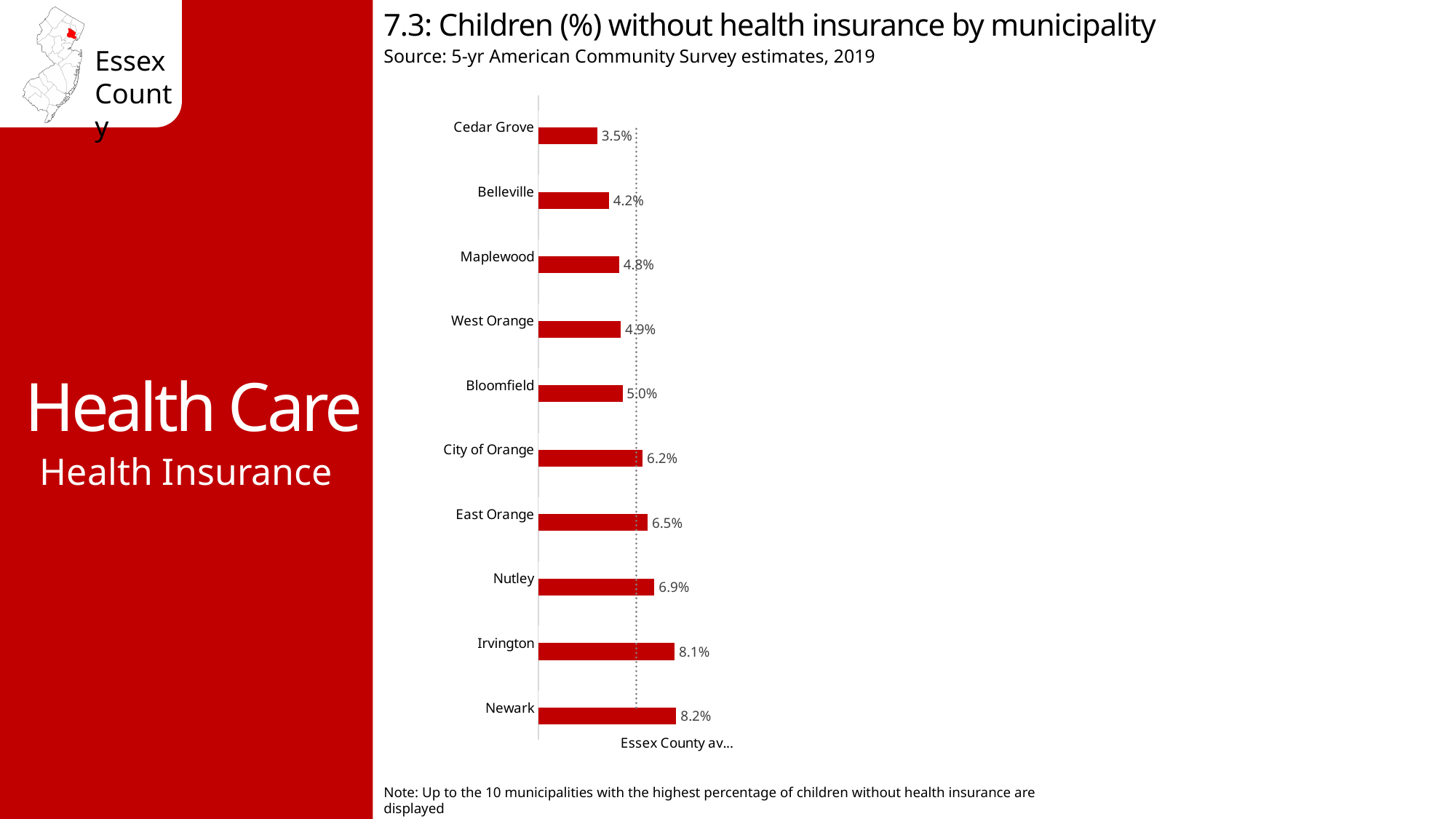
Which municipality has the highest percentage of children without health insurance? Newark What is the value shown for Maplewood? 4.8% What is the difference in percentage points between Newark and Cedar Grove? 4.7 How many percentage points higher is Nutley than Belleville? 2.7 What type of chart is used on this slide? Bar chart How many municipalities are shown in the chart? 10 Which municipality has the lowest percentage of children without health insurance? Cedar Grove Which has a higher percentage of children without health insurance, East Orange or Maplewood? East Orange What percentage of children in Newark are without health insurance? 8.2% Do the values increase or decrease going from the top bar to the bottom bar? Increase What does the dotted vertical line in the chart represent? Essex County average What percentage is shown for City of Orange? 6.2%